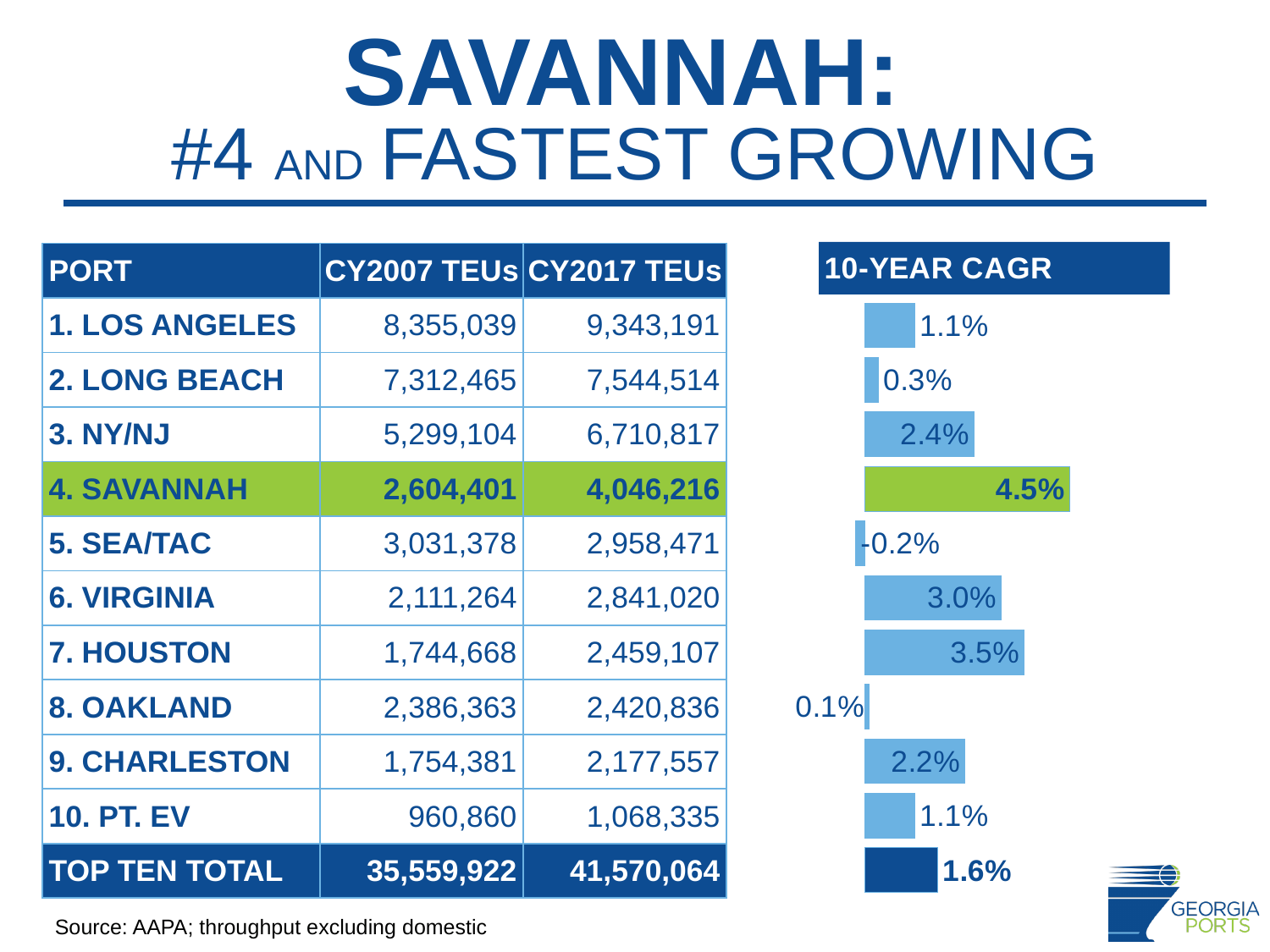
In the 10-YEAR CAGR chart, what colour is the bar for Savannah? green In the 10-YEAR CAGR chart, what is the value for Savannah? 4.5% In the 10-YEAR CAGR chart, what is the value for Sea/Tac? -0.2% In the 10-YEAR CAGR chart, which port has the highest 10-year CAGR? Savannah In the 10-YEAR CAGR chart, what is the value for Houston? 3.5% In the 10-YEAR CAGR chart, what is the value for the Top Ten Total? 1.6% In the 10-YEAR CAGR chart, which has the larger CAGR, Charleston or Long Beach? Charleston What kind of chart is the 10-YEAR CAGR chart? bar chart In the 10-YEAR CAGR chart, which port has the lowest 10-year CAGR? Sea/Tac How many bars are plotted in the 10-YEAR CAGR chart, including the Top Ten Total? 11 In the 10-YEAR CAGR chart, which has the larger CAGR, Houston or Virginia? Houston In the 10-YEAR CAGR chart, what is the difference between Savannah's CAGR and NY/NJ's CAGR? 2.1 percentage points